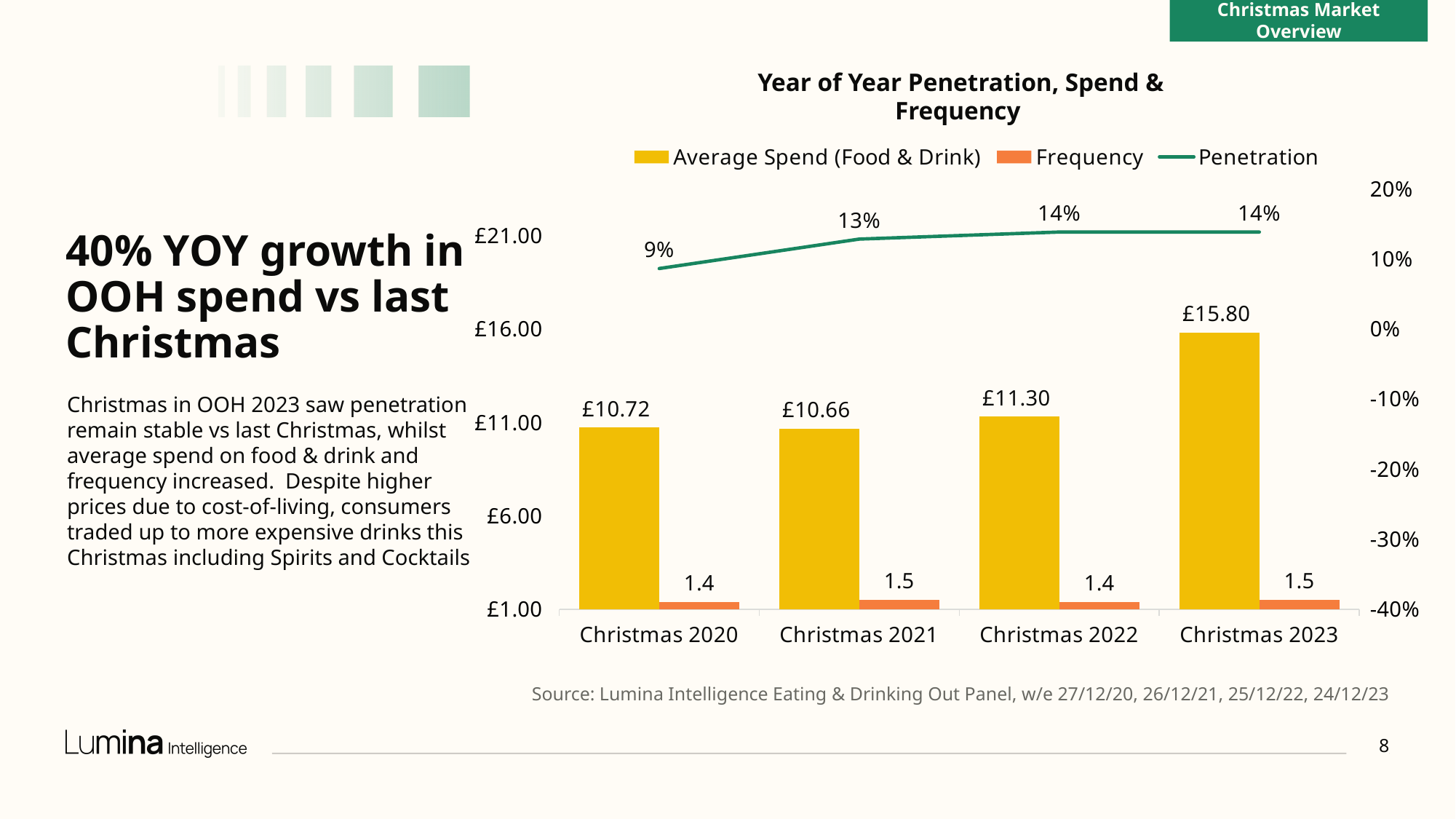
Which is larger, the Average Spend (Food & Drink) for Christmas 2020 or for Christmas 2021? Christmas 2020 How many series does the legend list? 3 What is the title of the chart? Year of Year Penetration, Spend & Frequency What kind of chart is used to show Average Spend (Food & Drink) and Frequency? Bar chart How many Christmas periods are shown on the x axis? 4 What is the Penetration value for Christmas 2021? 13% Which Christmas has the lowest Penetration? Christmas 2020 What is the difference in Average Spend (Food & Drink) between Christmas 2023 and Christmas 2022? £4.50 What is the Average Spend (Food & Drink) for Christmas 2023? £15.80 Which Christmas has the highest Average Spend (Food & Drink)? Christmas 2023 What is the Average Spend (Food & Drink) for Christmas 2020? £10.72 What is the Frequency value for Christmas 2022? 1.4